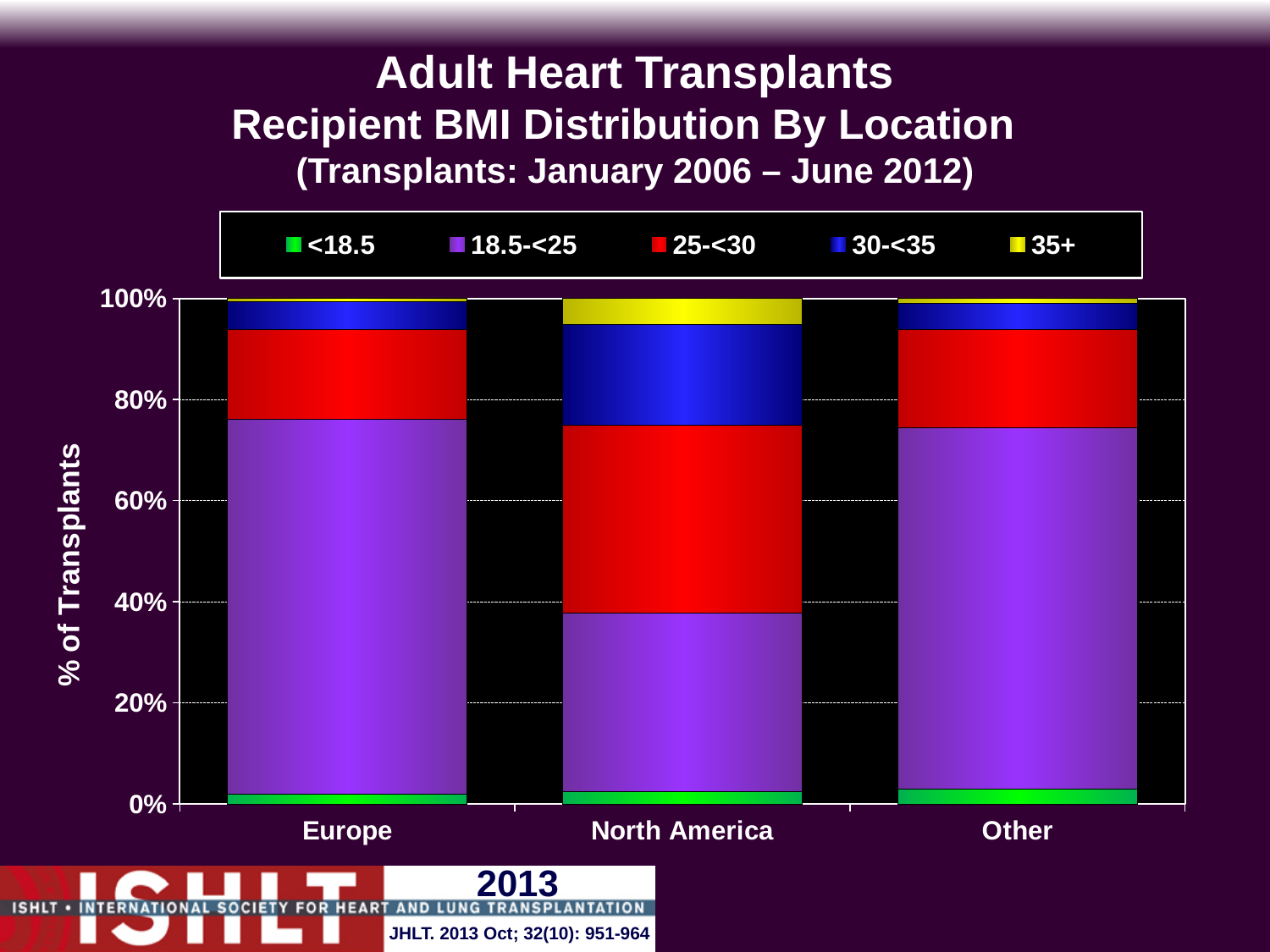
How many BMI categories does the legend list? 5 Which has a larger share of recipients with BMI 35+, North America or Other? North America What is the total height of the stacked bar for Europe? 100% Is the share of recipients with BMI 18.5-<25 in Europe greater or less than 60%? greater Which location has the smallest share of recipients with BMI 18.5-<25? North America What kind of chart is shown on the slide? Stacked bar chart Which location has the largest share of recipients with BMI 25-<30? North America What is the label on the y axis? % of Transplants Is the share of recipients with BMI 18.5-<25 in North America greater or less than 40%? less Which location has the largest share of recipients with BMI 30-<35? North America How many locations are shown on the x axis? 3 Which has a larger share of recipients with BMI 25-<30, Europe or North America? North America